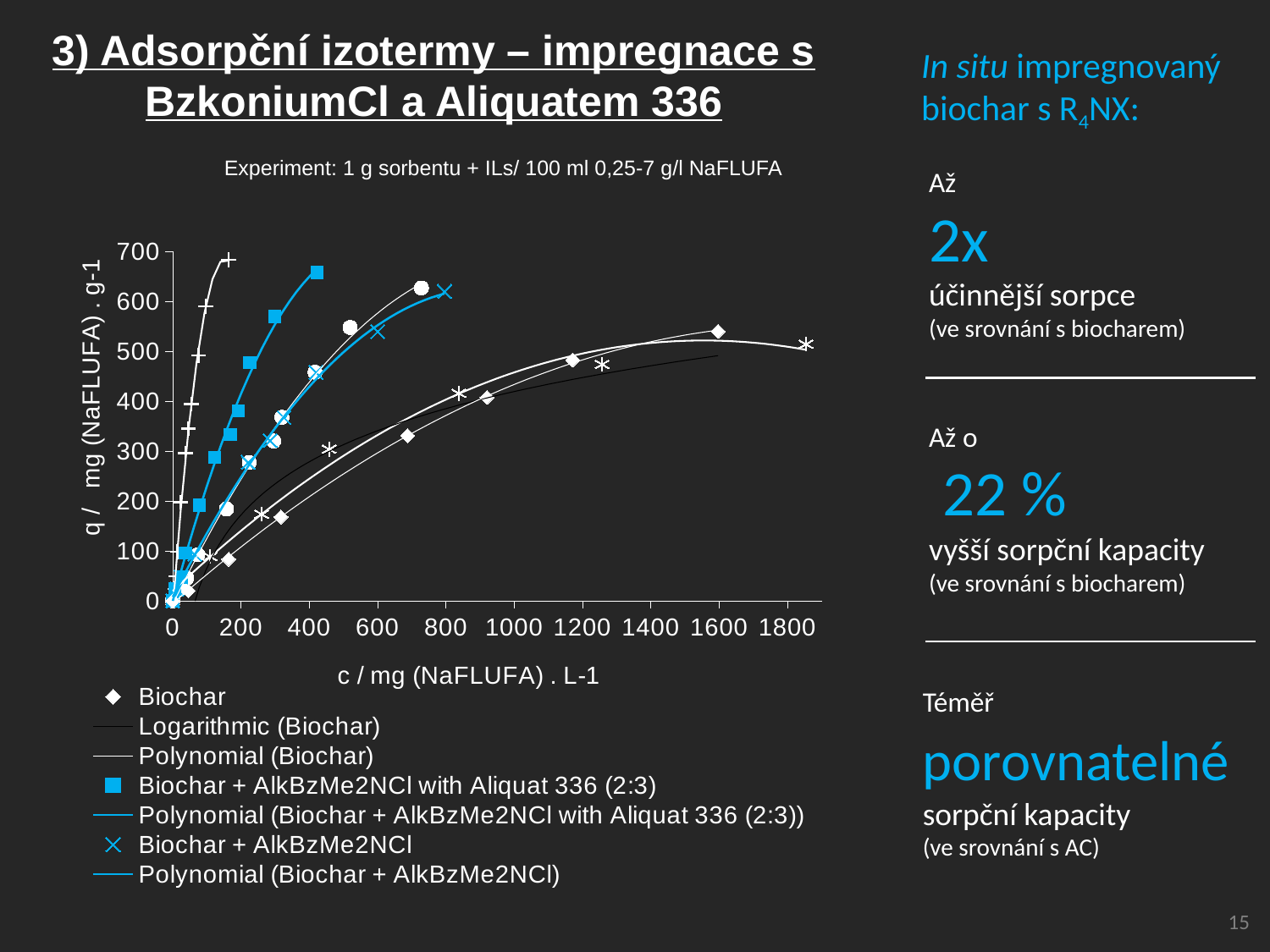
What is the label of the y axis of the chart? q / mg (NaFLUFA) . g-1 Is the highest plotted q value for the Biochar + AlkBzMe2NCl series greater or less than 500? greater What is the highest tick value shown on the y axis of the chart? 700 Is the highest plotted q value for the Biochar series greater or less than 500? greater What kind of chart is shown on the slide? scatter chart Is the highest plotted q value for the Biochar + AlkBzMe2NCl with Aliquat 336 (2:3) series greater or less than 600? greater What is the highest tick value shown on the x axis of the chart? 1800 Which series reaches a higher maximum q value: Biochar or Biochar + AlkBzMe2NCl with Aliquat 336 (2:3)? Biochar + AlkBzMe2NCl with Aliquat 336 (2:3) Do the q values of the Biochar series rise or fall as c increases along the x axis? rise What is the label of the x axis of the chart? c / mg (NaFLUFA) . L-1 How many entries does the chart legend list? 7